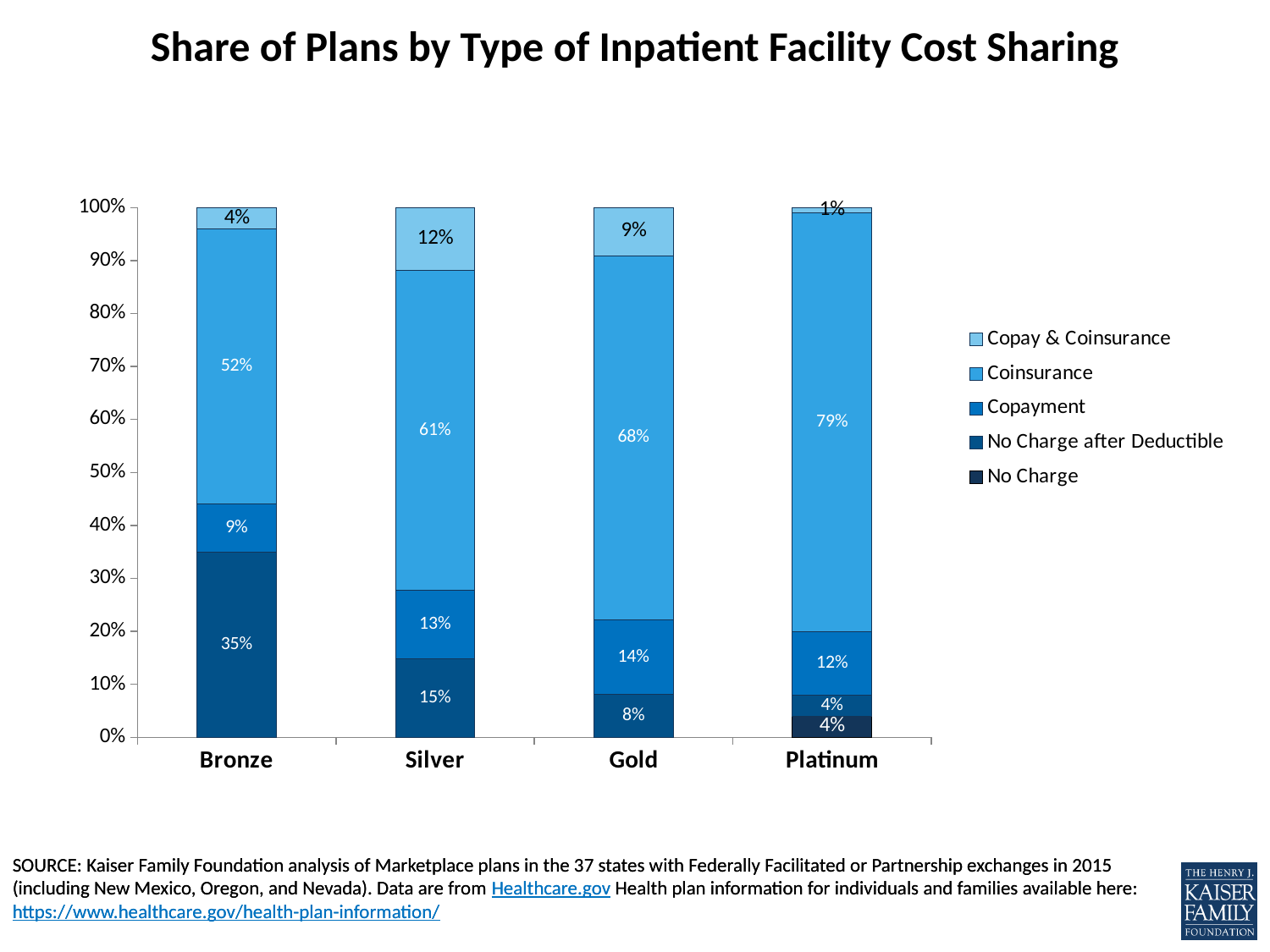
How many percentage points higher is the Coinsurance share for Gold than for Bronze? 16 percentage points What is the Copayment share for Silver plans? 13% What is the Coinsurance share for Platinum plans? 79% What is the value of the bottom segment of the Bronze bar? 35% What is the Copay & Coinsurance share for Gold plans? 9% What kind of chart is shown on the slide? Stacked bar chart Which plan type has the lowest Copay & Coinsurance share? Platinum Which plan type has the highest Coinsurance share? Platinum How many series does the legend list? 5 How many plan categories are shown on the x axis? 4 Which has a larger Copayment share, Gold or Platinum? Gold Does the Coinsurance share rise or fall from Bronze to Platinum? Rises